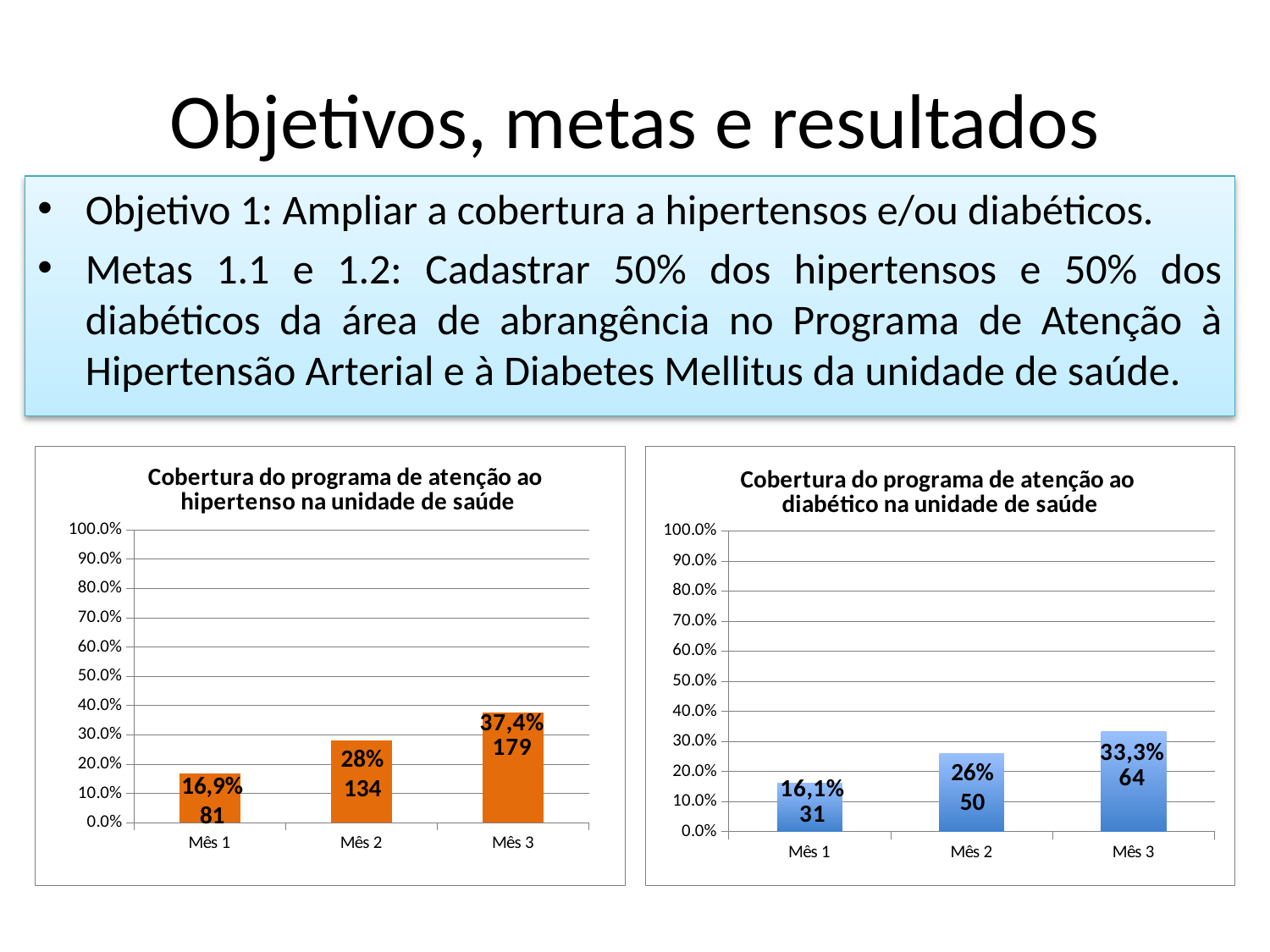
In the chart 'Cobertura do programa de atenção ao hipertenso na unidade de saúde', what is the difference in the number of patients between Mês 3 and Mês 2? 45 In the chart 'Cobertura do programa de atenção ao diabético na unidade de saúde', what is the difference in the number of patients between Mês 2 and Mês 1? 19 Which is larger: the Mês 3 coverage in the hipertenso chart or the Mês 3 coverage in the diabético chart? Hipertenso chart (37,4%) In the chart 'Cobertura do programa de atenção ao diabético na unidade de saúde', is the value for Mês 3 greater or less than 50.0%? less In the chart 'Cobertura do programa de atenção ao diabético na unidade de saúde', what is the coverage percentage for Mês 2? 26% In the chart 'Cobertura do programa de atenção ao hipertenso na unidade de saúde', what is the coverage percentage for Mês 1? 16,9% In the chart 'Cobertura do programa de atenção ao hipertenso na unidade de saúde', how many hypertensive patients are shown for Mês 3? 179 In the chart 'Cobertura do programa de atenção ao diabético na unidade de saúde', which month has the lowest coverage? Mês 1 In the chart 'Cobertura do programa de atenção ao diabético na unidade de saúde', how many diabetic patients are shown for Mês 1? 31 In the chart 'Cobertura do programa de atenção ao hipertenso na unidade de saúde', which month has the highest coverage? Mês 3 In the chart 'Cobertura do programa de atenção ao diabético na unidade de saúde', do the values rise or fall from Mês 1 to Mês 3? rise How many months (categories) are shown in the chart 'Cobertura do programa de atenção ao hipertenso na unidade de saúde'? 3